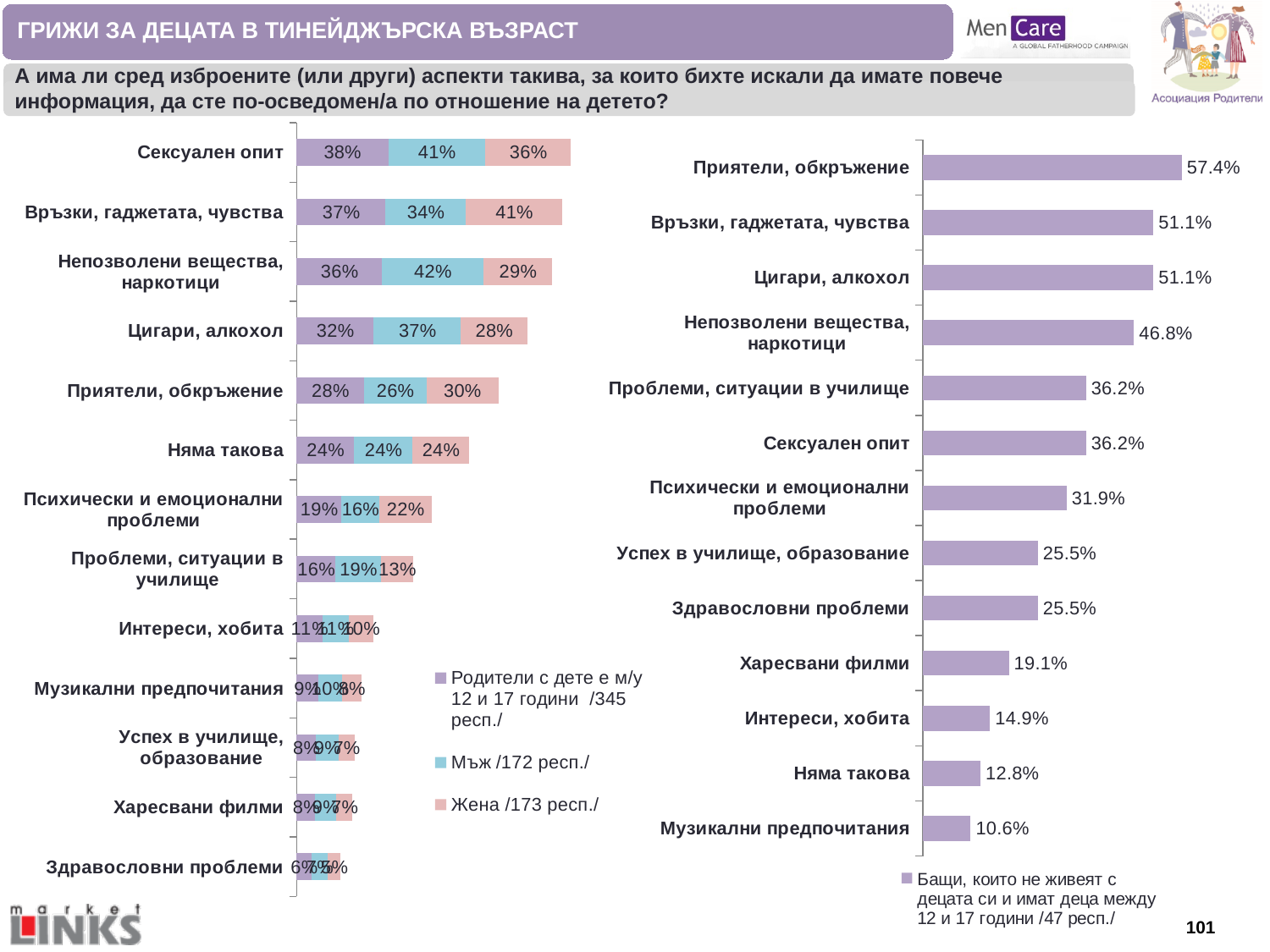
On the left chart, what percentage of Мъж /172 респ./ chose Сексуален опит? 41% On the right chart, what is the value for Проблеми, ситуации в училище? 36.2% On the left chart, what is the value for Жена /173 респ./ for Връзки, гаджетата, чувства? 41% On the left chart, what is the value for Родители с дете е м/у 12 и 17 години /345 респ./ for Непозволени вещества, наркотици? 36% On the right chart, which category has the highest value? Приятели, обкръжение What type of chart is the right chart? Bar chart On the left chart, for Цигари, алкохол, which is larger: the value for Мъж /172 респ./ or for Жена /173 респ./? Мъж /172 респ./ On the right chart, how many categories are shown? 13 On the right chart, which category has the lowest value? Музикални предпочитания On the left chart, how many series does the legend list? 3 On the left chart, what is the difference between the Мъж /172 респ./ and Жена /173 респ./ values for Сексуален опит? 5 percentage points On the right chart, what is the difference between the values for Приятели, обкръжение and Музикални предпочитания? 46.8 percentage points